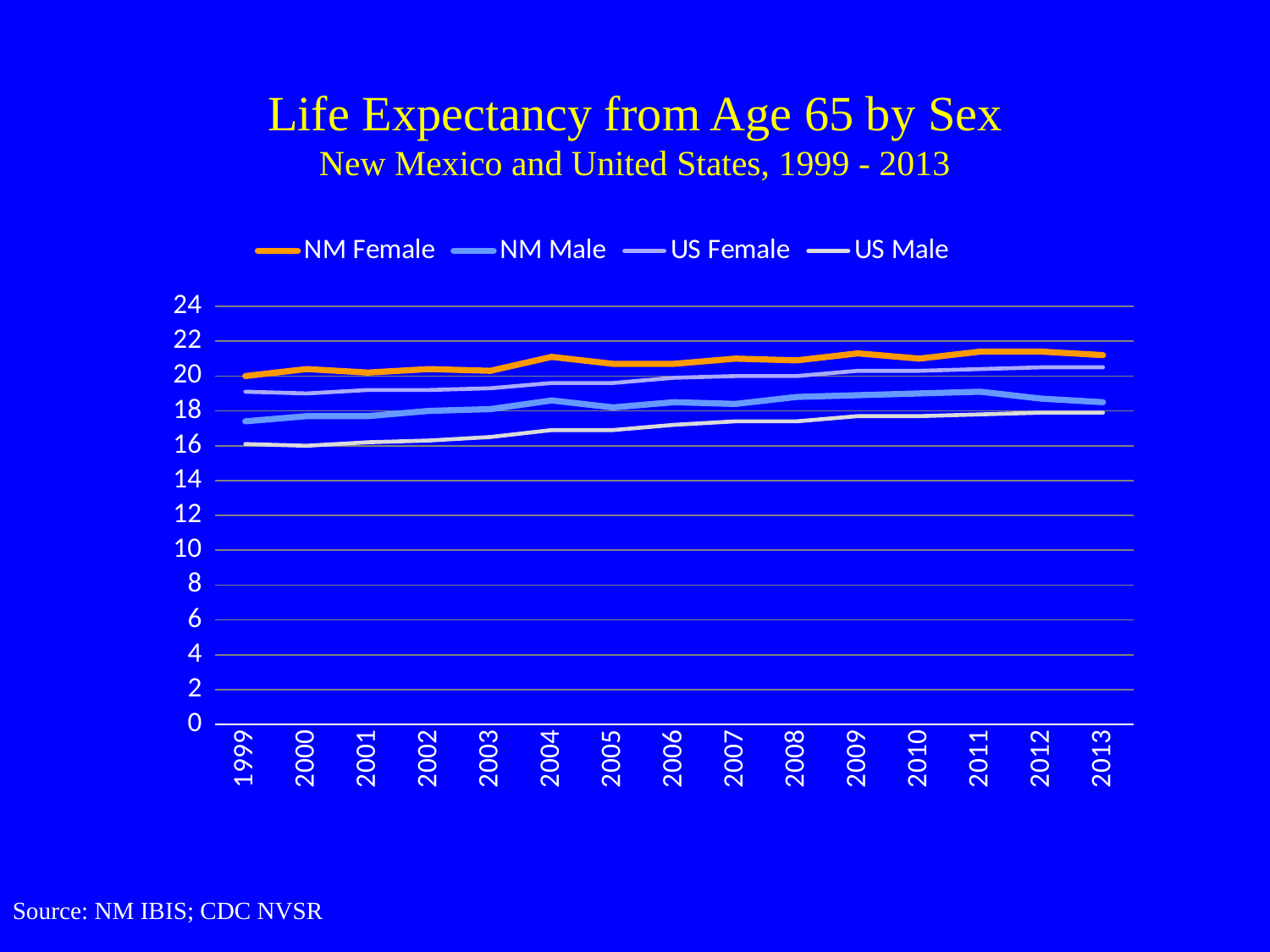
In 2013, which is larger: NM Female or US Female? NM Female What is the title of the chart? Life Expectancy from Age 65 by Sex Which series has the highest value in 2013? NM Female How many years are plotted along the x axis? 15 Does the US Male series generally rise or fall from 1999 to 2013? rise In 1999, which is larger: NM Male or US Male? NM Male How many series does the legend list? 4 Is the value for NM Female in 2013 greater or less than 20? greater Is the value for NM Male in 1999 greater or less than 18? less Is the value for US Male in 2013 greater or less than 16? greater Which series has the lowest value in 1999? US Male What kind of chart is shown on the slide? line chart